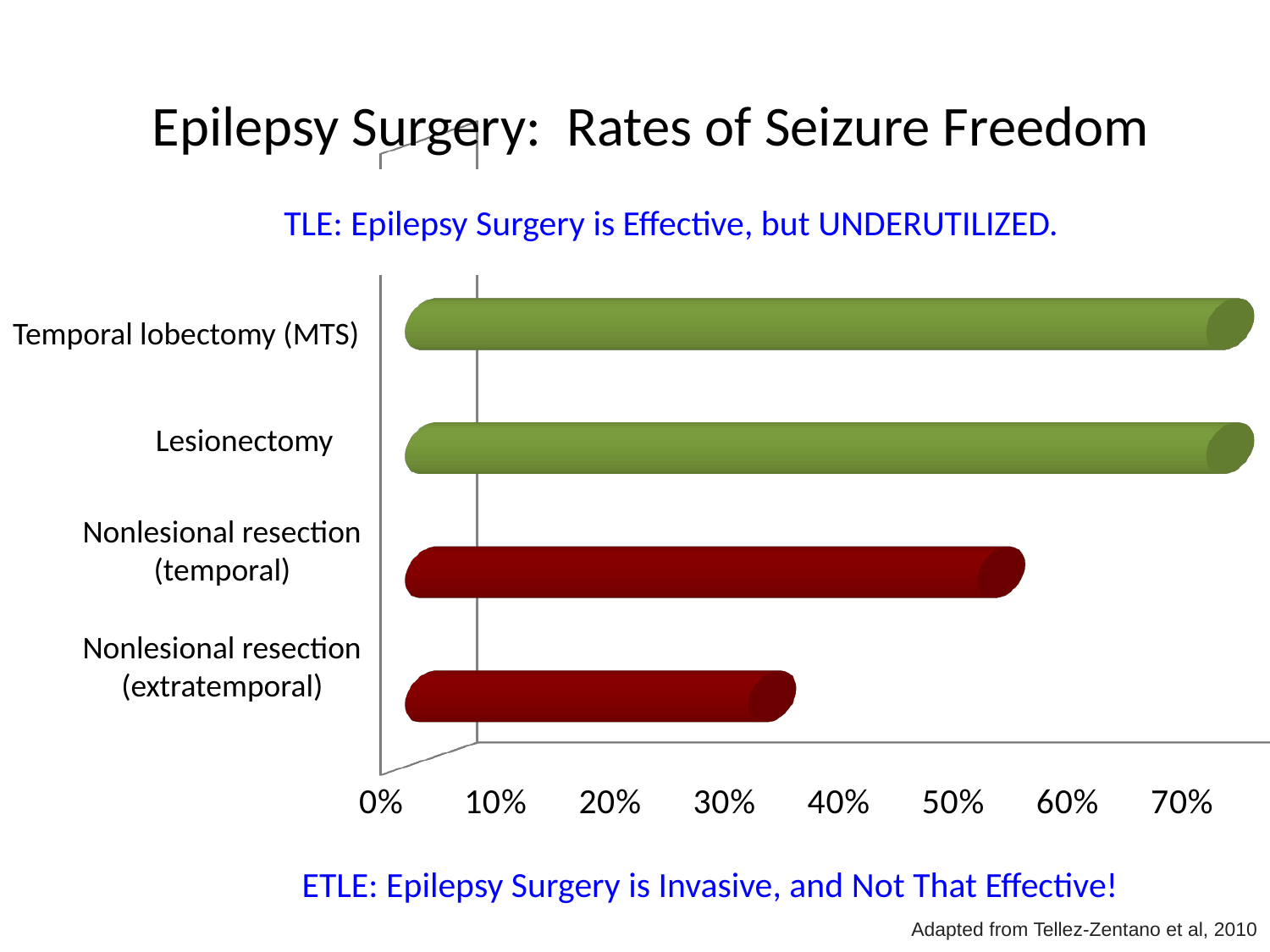
Is the value for Nonlesional resection (extratemporal) greater or less than 20%? greater What colour are the bars for the two nonlesional resection categories? red Is the value for Lesionectomy greater or less than 60%? greater What kind of chart is shown on the slide? bar chart Which category has the lowest rate of seizure freedom? Nonlesional resection (extratemporal) Is the value for Nonlesional resection (temporal) greater or less than 40%? greater Which is larger, the value for Lesionectomy or the value for Nonlesional resection (temporal)? Lesionectomy What is the title of the chart? Epilepsy Surgery: Rates of Seizure Freedom How many categories are plotted in the chart? 4